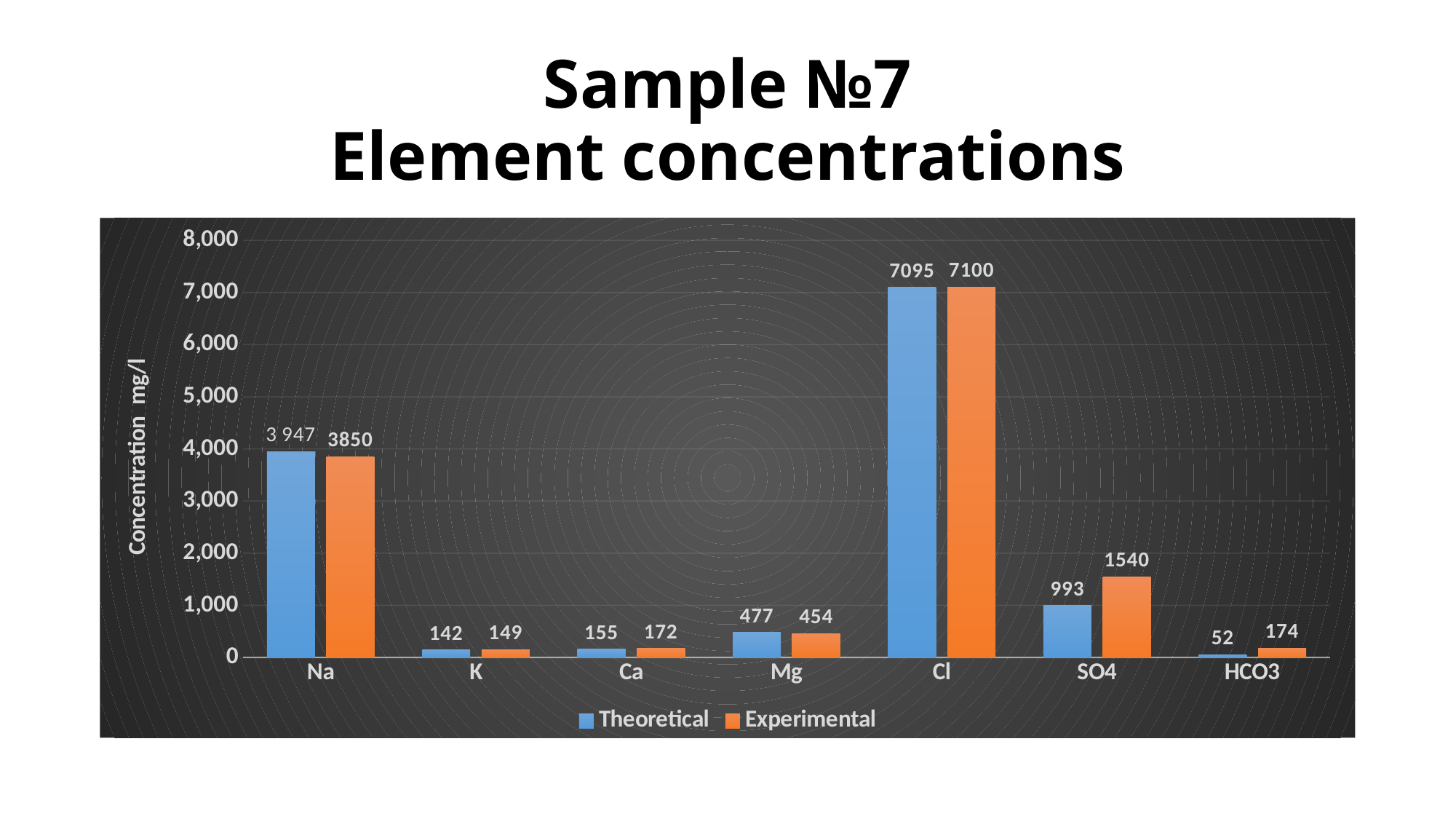
What is the difference between the Experimental and Theoretical concentrations for SO4? 547 What kind of chart is shown on the slide? bar chart What is the Theoretical concentration for Na? 3 947 What is the Experimental concentration for HCO3? 174 Is the Experimental value for Na greater or less than 4,000? less For HCO3, which is larger, the Theoretical or the Experimental concentration? Experimental How many series does the legend list? 2 What is the Experimental concentration for SO4? 1540 Which element has the highest Theoretical concentration? Cl Which element has the lowest Theoretical concentration? HCO3 How many elements are shown on the x axis? 7 What is the difference between the Theoretical and Experimental concentrations for Mg? 23